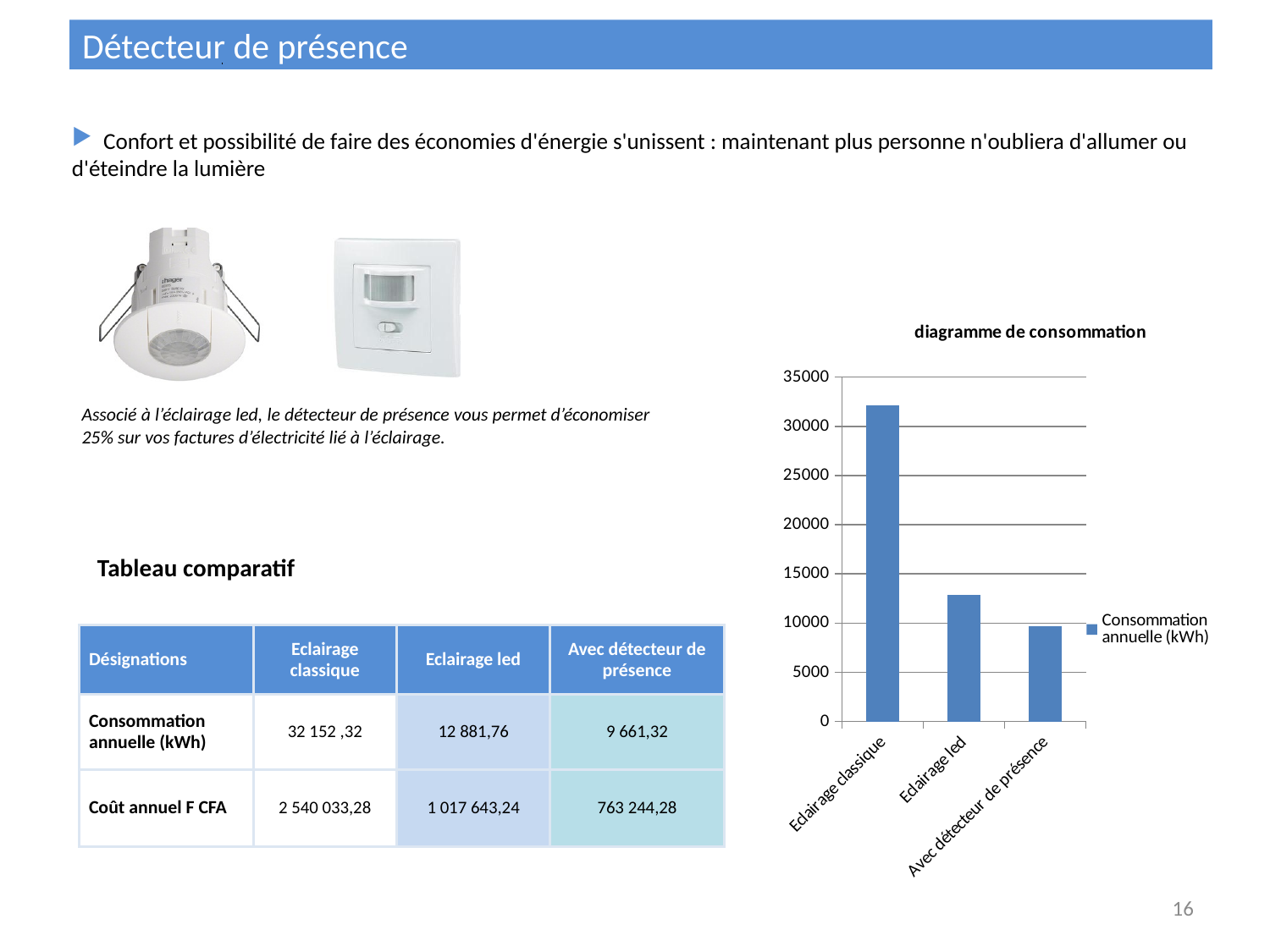
In the 'diagramme de consommation' chart, is the bar for Eclairage led greater or less than 15000? less How many series does the legend of the 'diagramme de consommation' chart list? 1 What is the title of the chart on the slide? diagramme de consommation Which category has the lowest bar in the 'diagramme de consommation' chart? Avec détecteur de présence In the 'diagramme de consommation' chart, is the bar for Avec détecteur de présence greater or less than 5000? greater In the 'diagramme de consommation' chart, which is larger: the bar for Eclairage led or the bar for Avec détecteur de présence? Eclairage led In the 'diagramme de consommation' chart, is the bar for Eclairage classique greater or less than 30000? greater Which category has the highest bar in the 'diagramme de consommation' chart? Eclairage classique What kind of chart is the 'diagramme de consommation'? bar chart How many categories are shown on the x axis of the 'diagramme de consommation' chart? 3 Do the bars in the 'diagramme de consommation' chart rise or fall from left to right? fall What is the legend entry of the 'diagramme de consommation' chart? Consommation annuelle (kWh)